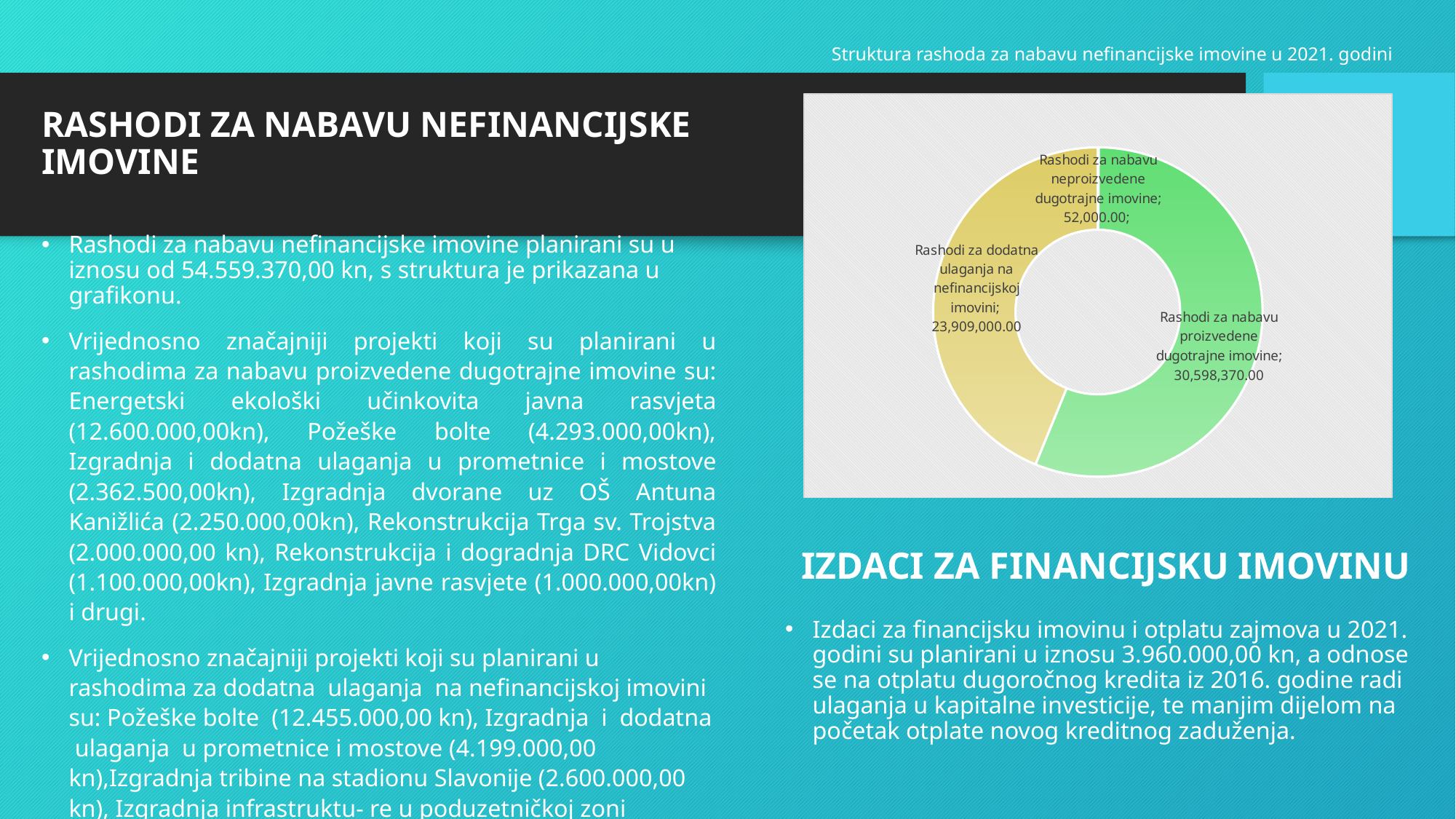
What is the total of all slices in the chart? 54,559,370.00 Which category has the smallest value in the chart? Rashodi za nabavu neproizvedene dugotrajne imovine What type of chart is shown on the slide? Doughnut (pie) chart How many categories (slices) does the chart show? 3 Which is larger: Rashodi za dodatna ulaganja na nefinancijskoj imovini or Rashodi za nabavu neproizvedene dugotrajne imovine? Rashodi za dodatna ulaganja na nefinancijskoj imovini What is the value for Rashodi za dodatna ulaganja na nefinancijskoj imovini? 23,909,000.00 What is the value for Rashodi za nabavu neproizvedene dugotrajne imovine? 52,000.00 What is the difference between the values for Rashodi za nabavu proizvedene dugotrajne imovine and Rashodi za dodatna ulaganja na nefinancijskoj imovini? 6,689,370.00 Which category has the largest value in the chart? Rashodi za nabavu proizvedene dugotrajne imovine What is the value for Rashodi za nabavu proizvedene dugotrajne imovine? 30,598,370.00